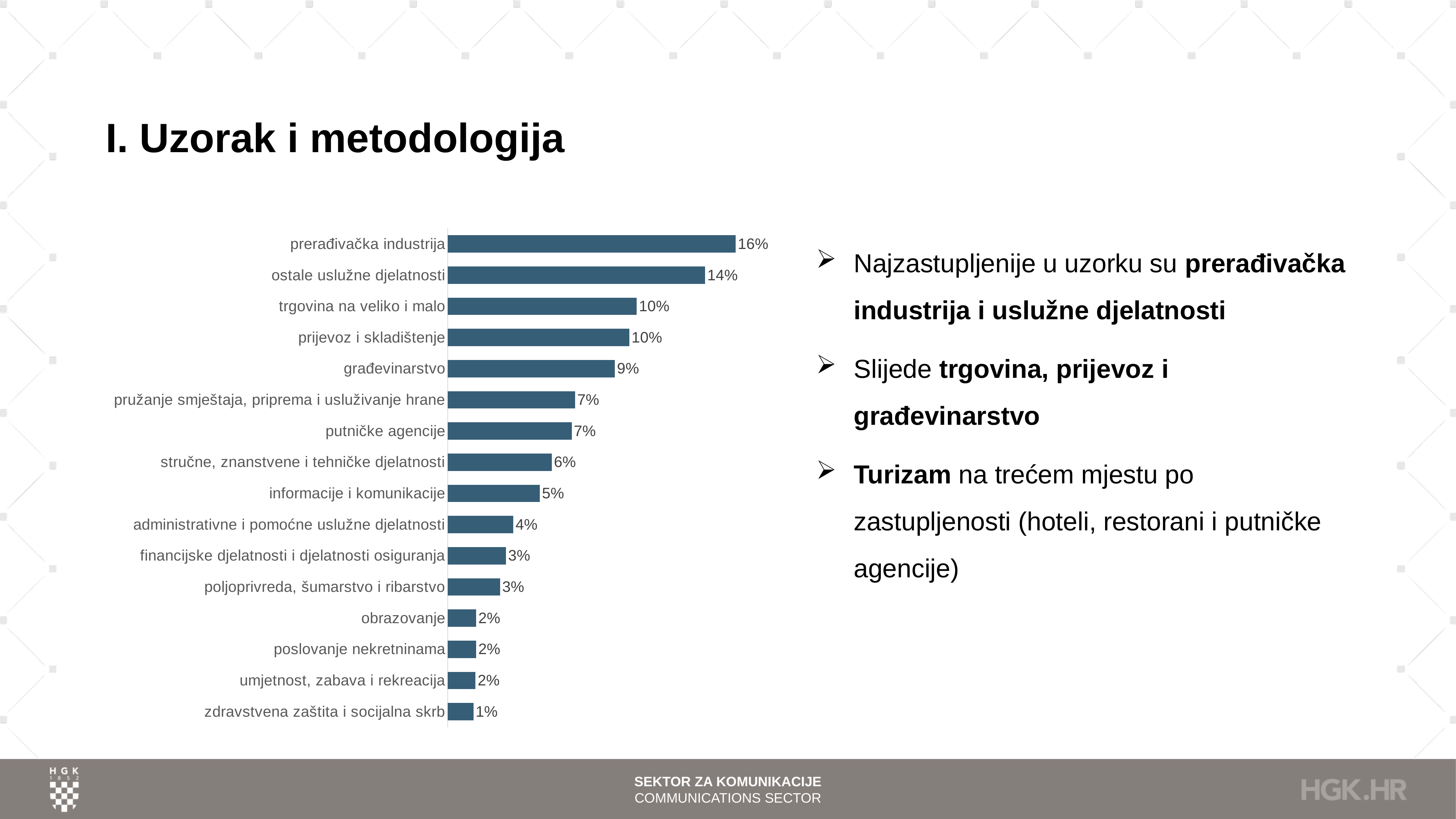
How many categories are shown in the chart? 16 What is the value for informacije i komunikacije? 5% What is the value for administrativne i pomoćne uslužne djelatnosti? 4% Which is larger, the value for obrazovanje or the value for financijske djelatnosti i djelatnosti osiguranja? financijske djelatnosti i djelatnosti osiguranja Which category has the lowest value? zdravstvena zaštita i socijalna skrb What is the value for prerađivačka industrija? 16% What is the value for građevinarstvo? 9% What is the difference between the values for trgovina na veliko i malo and stručne, znanstvene i tehničke djelatnosti? 4% Which category has the highest value? prerađivačka industrija What is the difference between the values for prerađivačka industrija and ostale uslužne djelatnosti? 2% Which is larger, the value for građevinarstvo or the value for putničke agencije? građevinarstvo What kind of chart is shown on the slide? bar chart